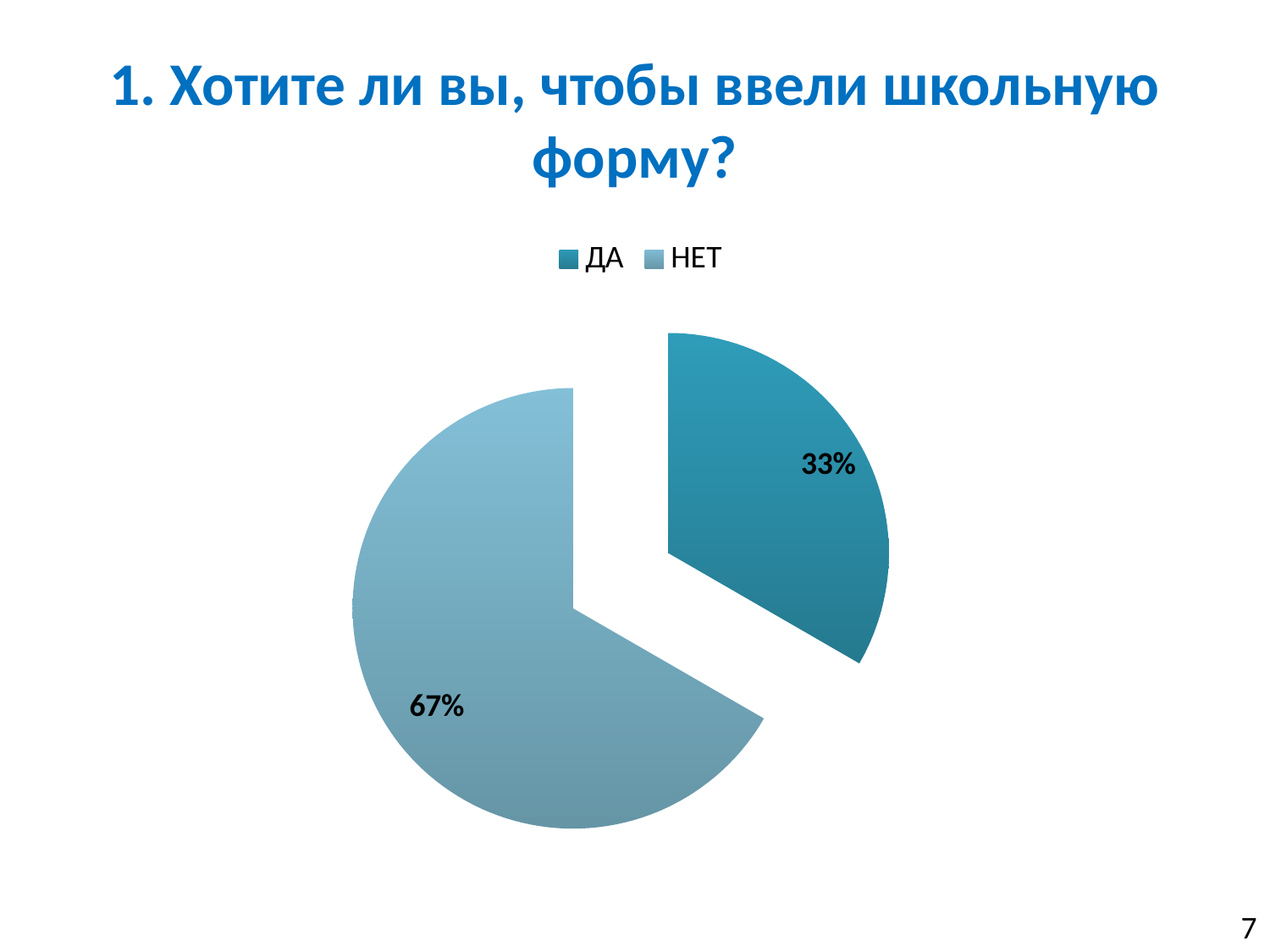
Which category has the smallest slice of the pie? ДА What share of the pie does ДА have? 33% What kind of chart is shown on the slide? pie chart How many entries does the legend list? 2 What is the difference in percentage points between the НЕТ slice and the ДА slice? 34% What share of the pie does НЕТ have? 67% Which slice is pulled out (exploded) from the rest of the pie? ДА Which category has the largest slice of the pie? НЕТ What is the title of the slide above the chart? 1. Хотите ли вы, чтобы ввели школьную форму? Which is larger, the slice for ДА or the slice for НЕТ? НЕТ How many slices does the pie chart have? 2